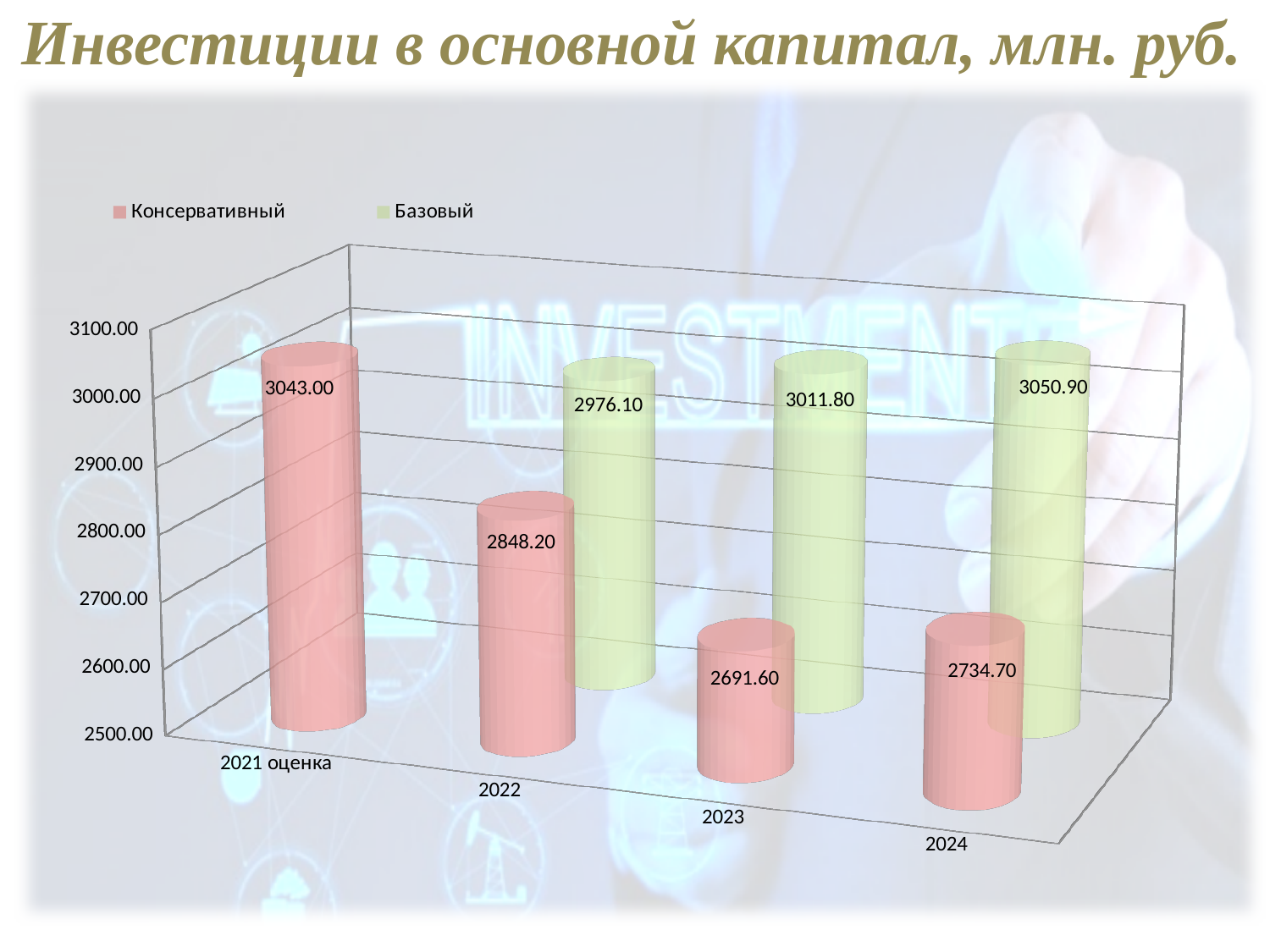
Do the Базовый values rise or fall from 2022 to 2024? Rise What is the value for Базовый in 2024? 3050.90 In which year is the Консервативный value lowest? 2023 What is the value for Базовый in 2023? 3011.80 What is the value for Консервативный in 2021 оценка? 3043.00 How many series does the legend list? 2 In which year is the Консервативный value highest? 2021 оценка How many categories are shown on the x axis? 4 Which is larger in 2022, Консервативный or Базовый? Базовый What kind of chart is shown on the slide? Bar chart What is the difference between the Базовый and Консервативный values in 2023? 320.20 What is the value for Консервативный in 2022? 2848.20